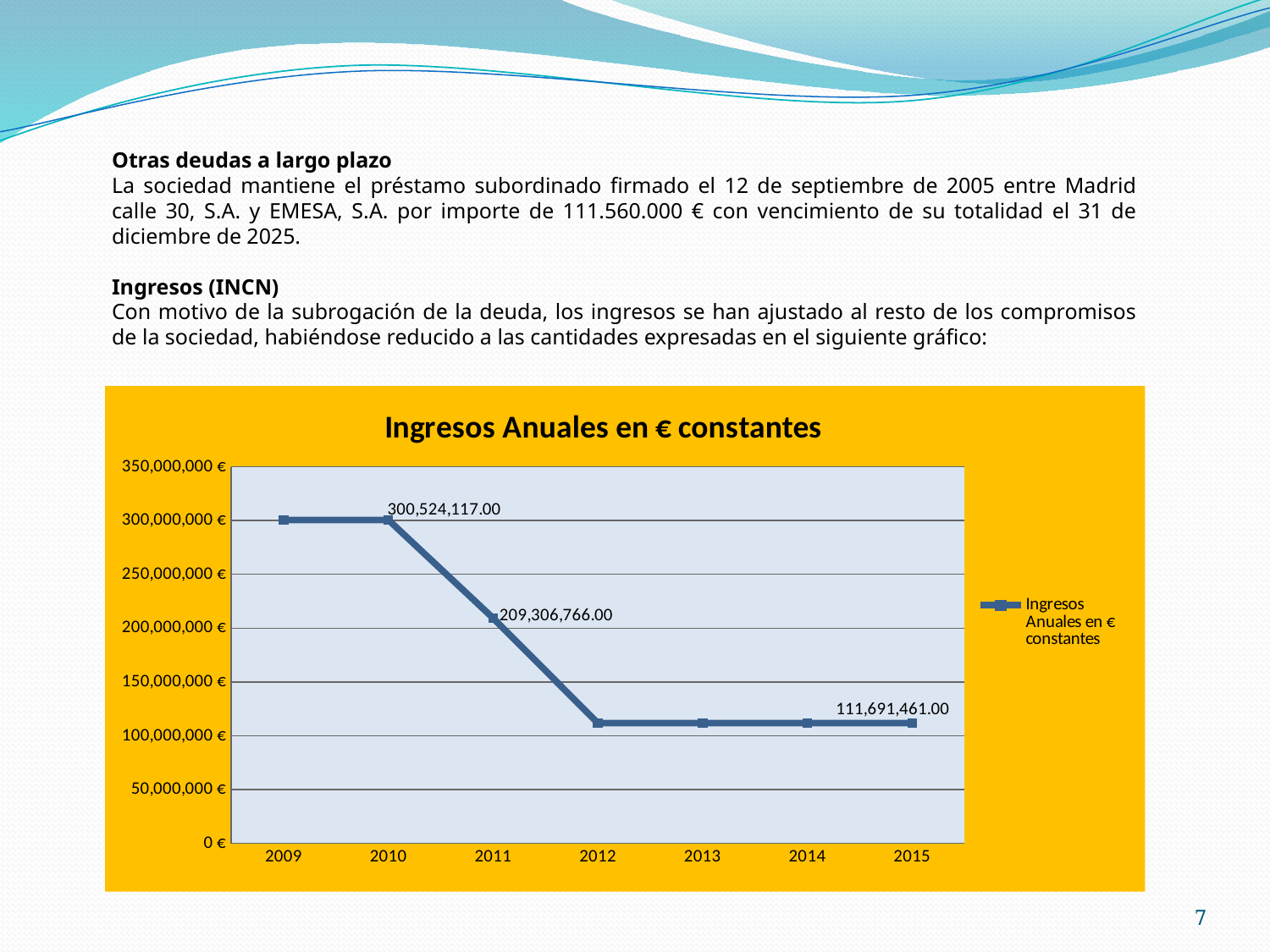
What kind of chart is shown on the slide? line chart What is the difference between the labelled values for 2011 and 2015? 97,615,305.00 How many years are plotted on the x axis of the chart? 7 Is the value for 2013 greater or less than 150,000,000 €? less What is the value labelled for 2015 in the chart? 111,691,461.00 How many series does the chart's legend list? 1 What is the value labelled for 2010 in the chart? 300,524,117.00 Is the value for 2009 greater or less than 250,000,000 €? greater What is the value labelled for 2011 in the chart? 209,306,766.00 What is the difference between the labelled values for 2010 and 2011? 91,217,351.00 Do the values in the chart rise or fall from 2009 to 2015? fall What is the title of the chart? Ingresos Anuales en € constantes